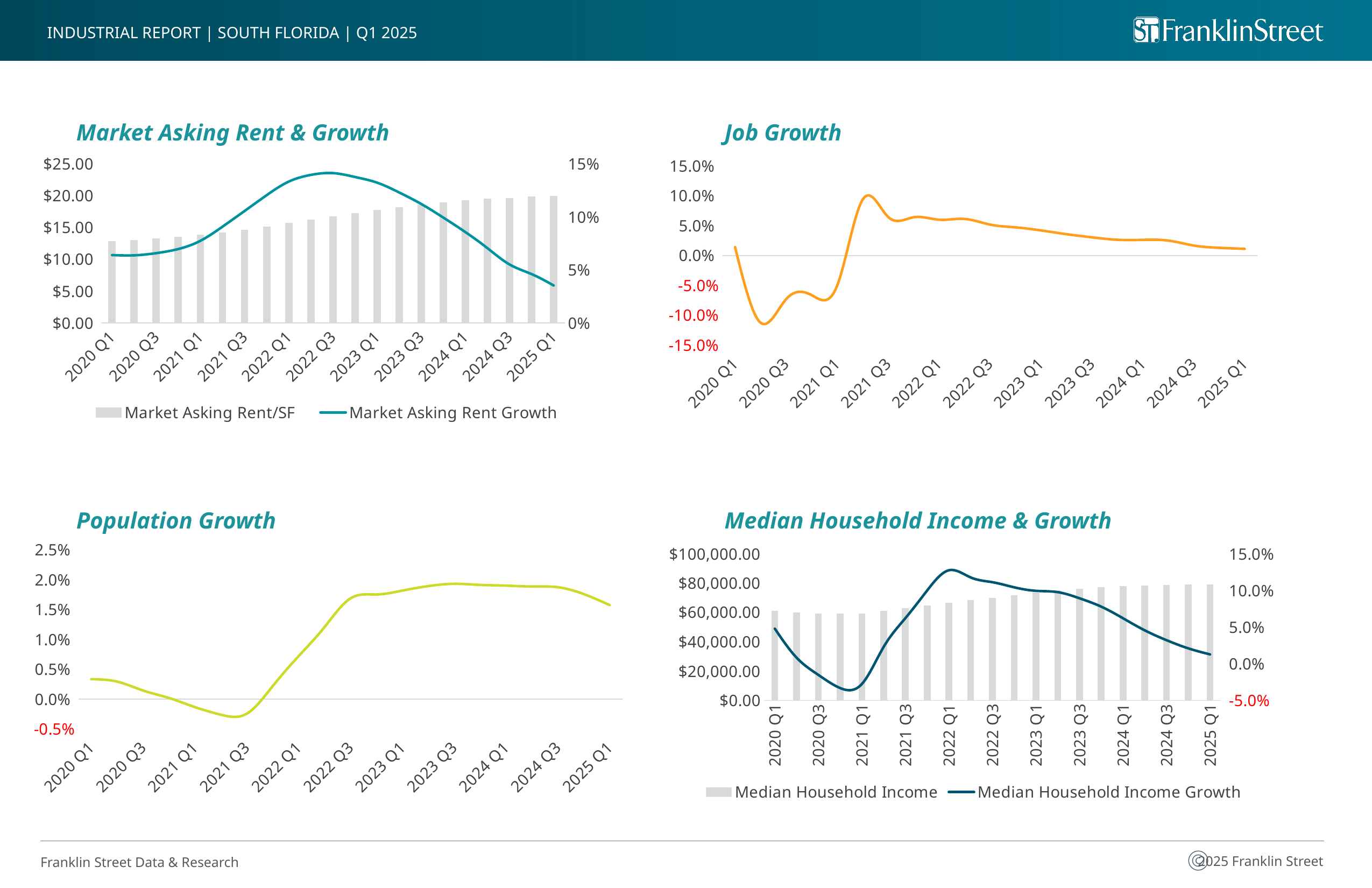
In the Median Household Income & Growth chart, is the Median Household Income value for 2025 Q1 greater or less than $60,000.00? greater In the Market Asking Rent & Growth chart, how many series does the legend list? 2 In the Median Household Income & Growth chart, how many series does the legend list? 2 In the Population Growth chart, is the value for 2025 Q1 greater or less than 1.0%? greater What kind of chart is the Job Growth chart? line chart In the Job Growth chart, is the value for 2025 Q1 greater or less than 5.0%? less In the Market Asking Rent & Growth chart, do the Market Asking Rent/SF bars rise or fall from 2020 Q1 to 2025 Q1? rise